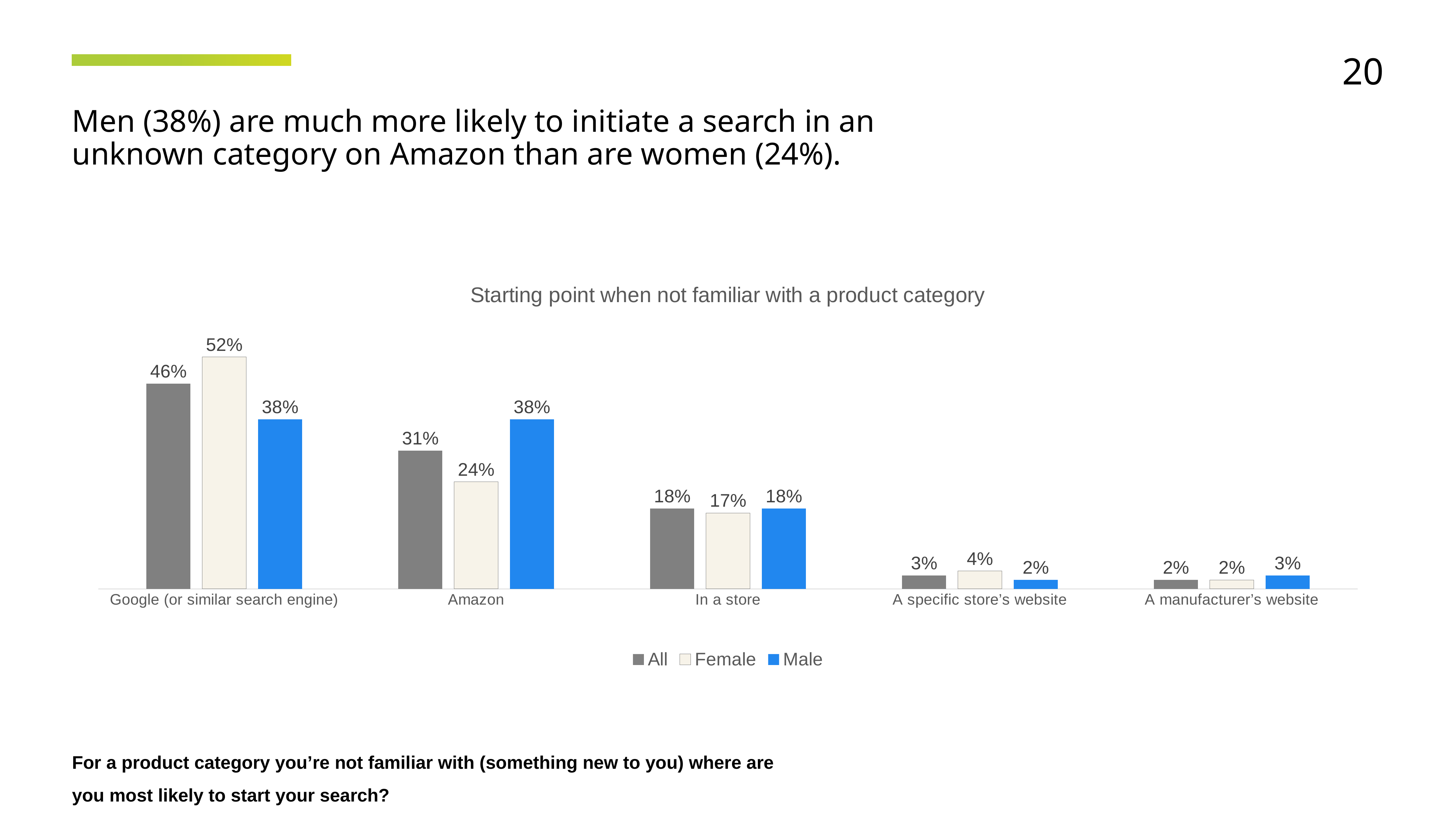
What is the Female value for A specific store's website? 4% Which category has the highest Male value? Google (or similar search engine) and Amazon (tied at 38%) How many series does the legend list? 3 Which is larger for Google (or similar search engine): the Female value or the Male value? Female How many categories are shown on the x axis? 5 What is the title of the chart? Starting point when not familiar with a product category What is the difference between the Male and Female values for Amazon? 14% What is the Female value for Google (or similar search engine)? 52% What is the All value for In a store? 18% Which category has the lowest Female value? A manufacturer's website What is the Male value for Amazon? 38% What kind of chart is shown? Bar chart